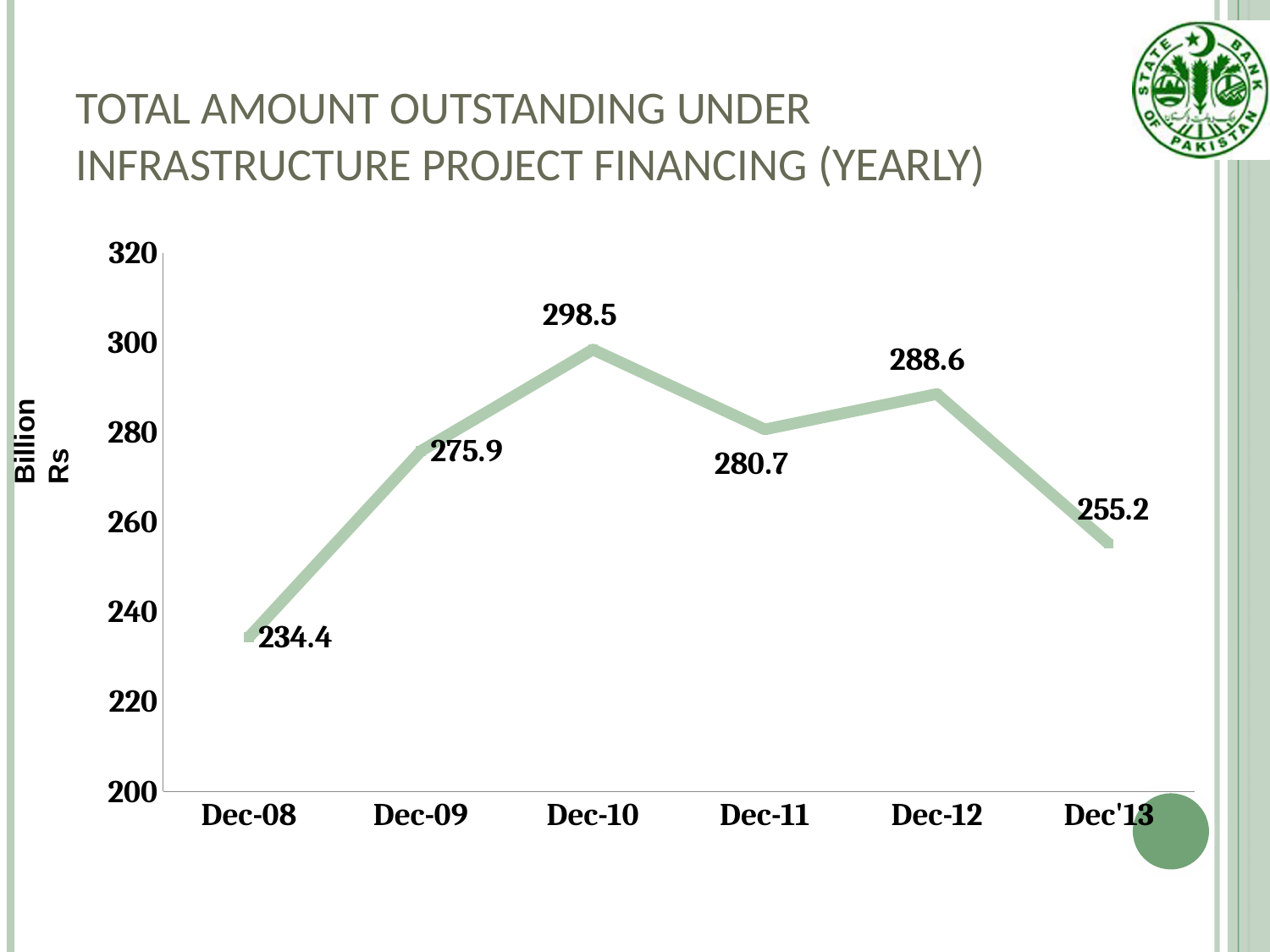
How many data points are plotted on the chart? 6 What is the difference between the values for Dec-12 and Dec'13? 33.4 Which year has the lowest amount outstanding? Dec-08 Which is larger, the value for Dec-09 or the value for Dec-11? Dec-11 Which year has the highest amount outstanding? Dec-10 What is the value shown for Dec'13? 255.2 Is the value for Dec-12 greater or less than 280? greater What is the total amount outstanding in Dec-10? 298.5 What is the difference between the values for Dec-10 and Dec-11? 17.8 What is the value shown for Dec-08? 234.4 What unit is shown on the vertical axis label? Billion Rs What kind of chart is shown on the slide? Line chart